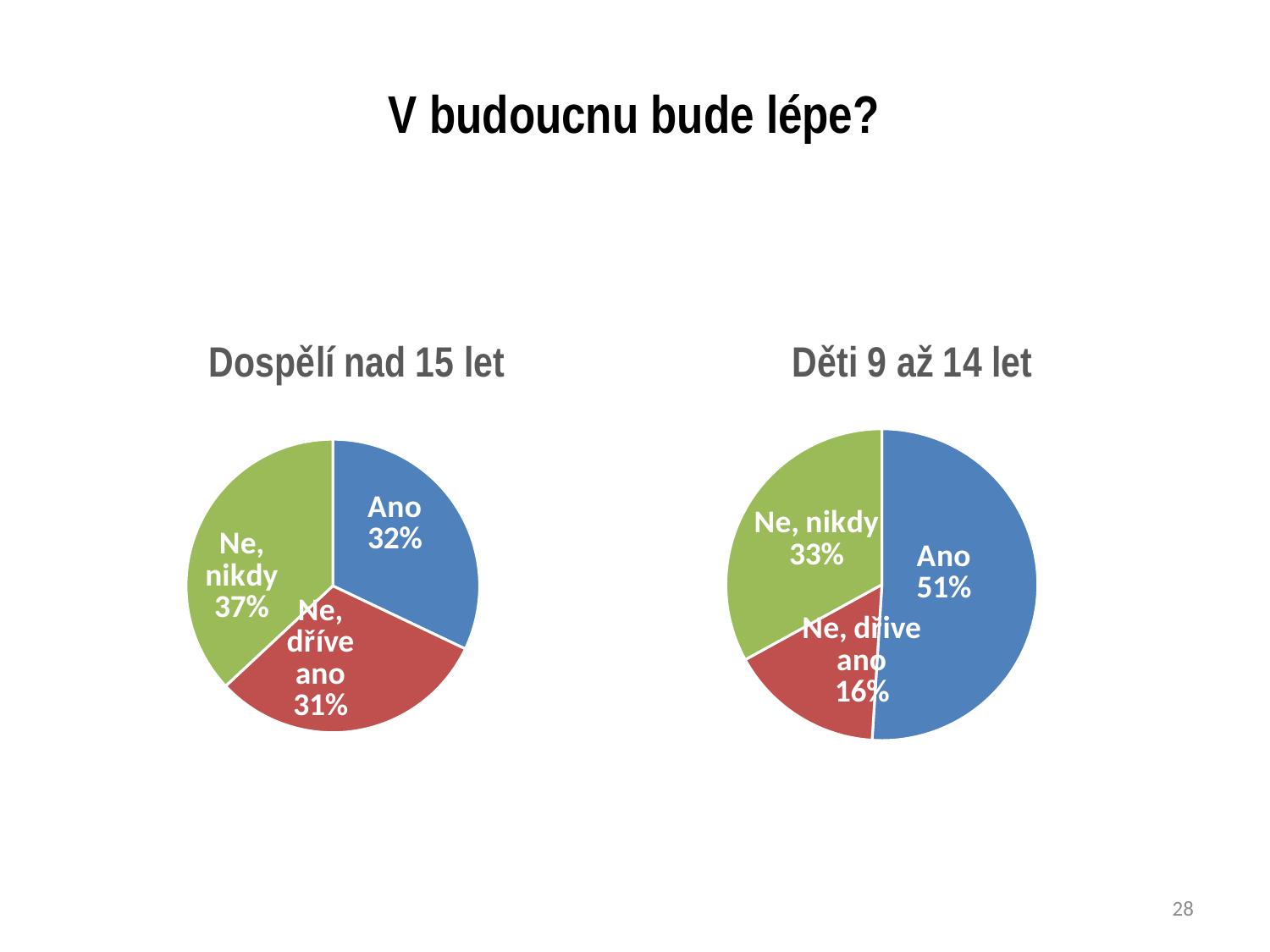
How many slices does the 'Dospělí nad 15 let' chart have? 3 Which chart has the larger share for 'Ano', 'Dospělí nad 15 let' or 'Děti 9 až 14 let'? Děti 9 až 14 let What kind of chart is the 'Děti 9 až 14 let' chart? Pie chart In the 'Dospělí nad 15 let' chart, which category has the largest share? Ne, nikdy In the 'Děti 9 až 14 let' chart, what is the difference between 'Ano' and 'Ne, nikdy'? 18% In the 'Dospělí nad 15 let' chart, what is the value for 'Ano'? 32% In the 'Děti 9 až 14 let' chart, which category has the smallest share? Ne, dříve ano In the 'Dospělí nad 15 let' chart, what is the value for 'Ne, nikdy'? 37% What is the title of the slide above the two charts? V budoucnu bude lépe? In the 'Děti 9 až 14 let' chart, what is the value for 'Ne, dříve ano'? 16% In the 'Děti 9 až 14 let' chart, what is the value for 'Ano'? 51% In the 'Dospělí nad 15 let' chart, what is the difference between 'Ne, nikdy' and 'Ne, dříve ano'? 6%